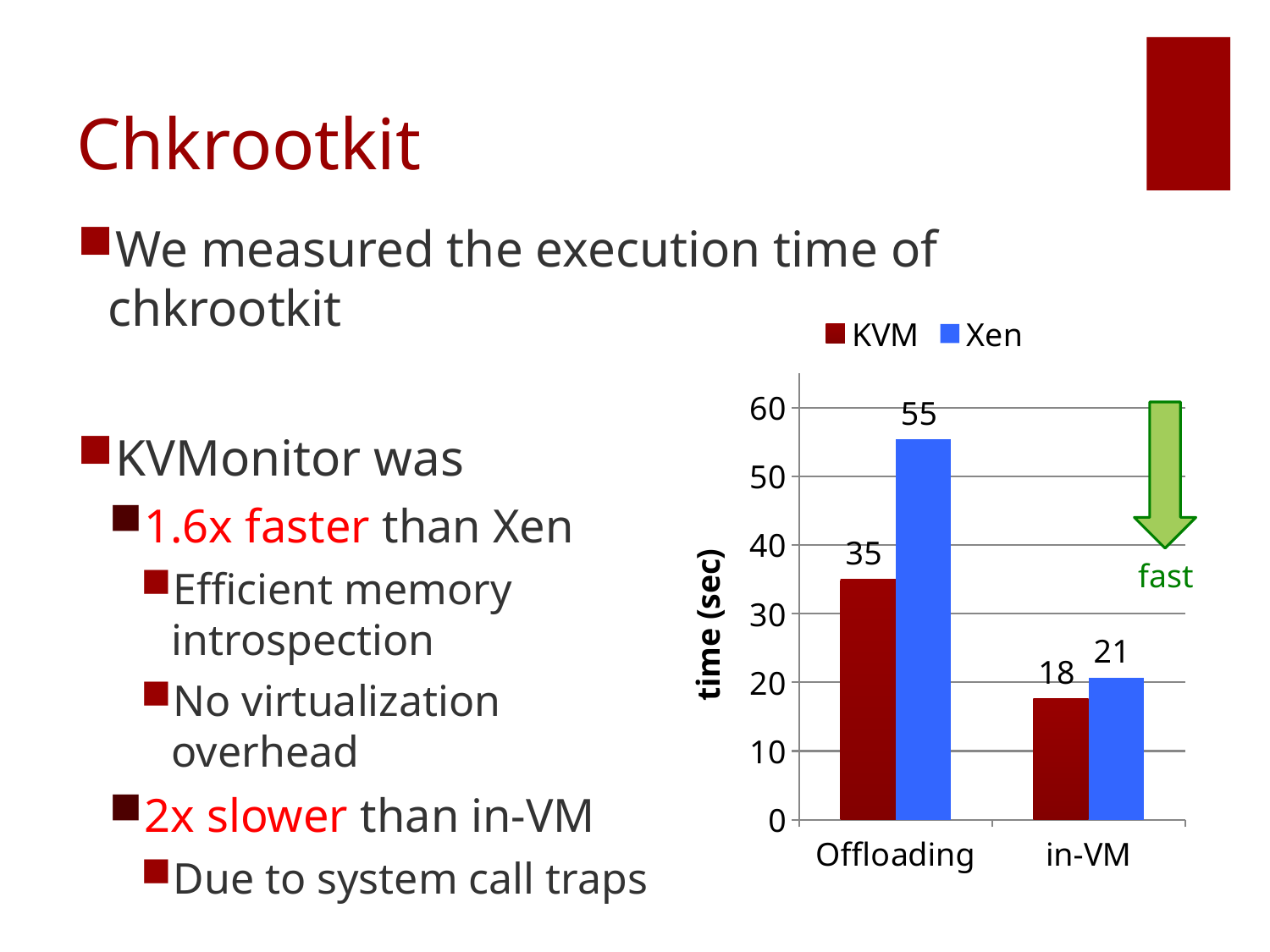
What is the KVM execution time for in-VM? 18 What is the difference between the Xen and KVM times for Offloading? 20 How many series does the legend list? 2 What is the Xen execution time for Offloading? 55 Which bar has the lowest value in the chart? KVM, in-VM Which bar has the highest value in the chart? Xen, Offloading What is the Xen execution time for in-VM? 21 What kind of chart is shown on the slide? bar chart Which is larger for in-VM, the KVM time or the Xen time? Xen What is the KVM execution time for Offloading? 35 What is the label of the y axis? time (sec) How many categories are shown on the x axis? 2